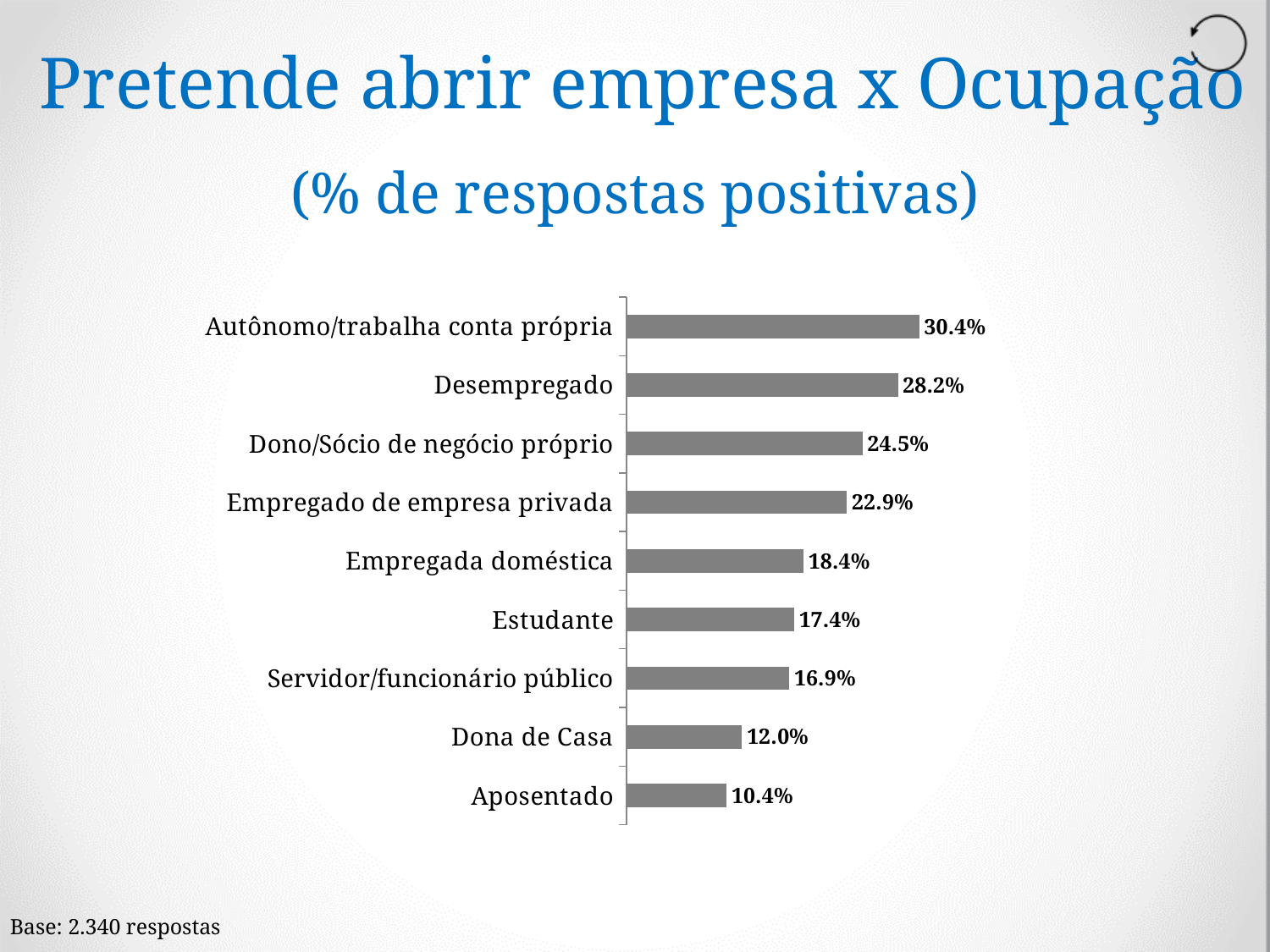
Which occupation has the lowest percentage of positive responses? Aposentado What kind of chart is shown on the slide? Bar chart What is the difference between the values for Dono/Sócio de negócio próprio and Empregado de empresa privada? 1.6% Which occupation has the highest percentage of positive responses? Autônomo/trabalha conta própria What is the base number of responses stated on the slide? 2.340 respostas How many occupation categories are shown in the chart? 9 What is the title of the slide? Pretende abrir empresa x Ocupação (% de respostas positivas) What is the value for Dona de Casa? 12.0% Which is larger, the value for Estudante or the value for Dona de Casa? Estudante What is the value for Desempregado? 28.2% What is the value for Empregada doméstica? 18.4% What is the difference between the values for Autônomo/trabalha conta própria and Aposentado? 20.0%